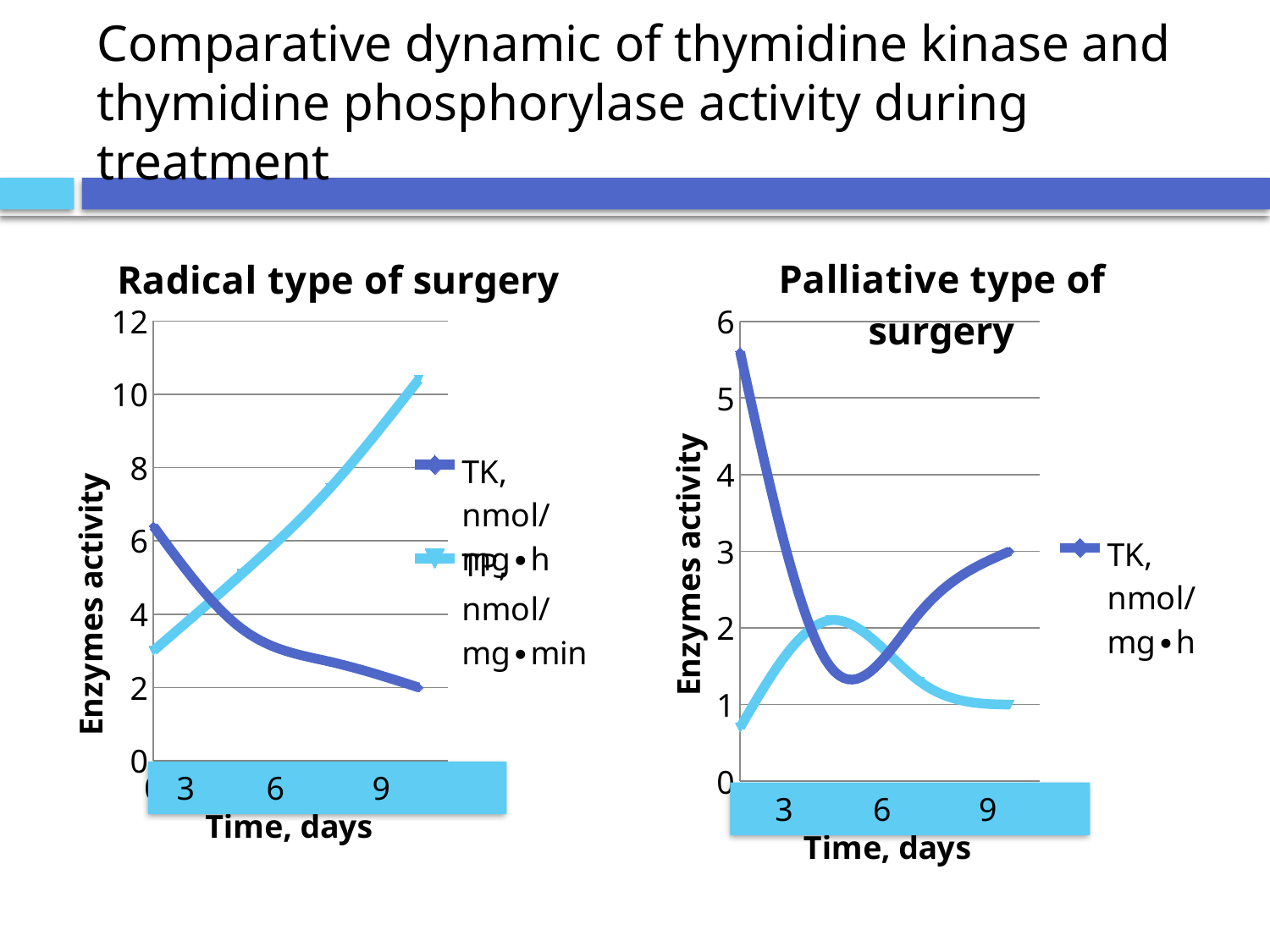
How many series does the legend of the 'Radical type of surgery' chart list? 2 What is the y-axis title of the 'Radical type of surgery' chart? Enzymes activity In the 'Radical type of surgery' chart, is the final value of the TP series greater or less than 8? greater How many series does the legend of the 'Palliative type of surgery' chart list? 1 In the 'Radical type of surgery' chart, what value does the TK series end at? 2 In the 'Palliative type of surgery' chart, what value does the TK series end at? 3 In the 'Radical type of surgery' chart, does the TK series rise or fall over time? fall What kind of chart is the 'Radical type of surgery' chart? line chart In the 'Radical type of surgery' chart, does the TP series rise or fall over time? rise In the 'Palliative type of surgery' chart, is the starting value of the TK series greater or less than 5? greater In the 'Palliative type of surgery' chart, at the start of the period, which series has the larger value: the dark blue TK line or the light blue line? TK In the 'Radical type of surgery' chart, which series reaches the highest value? TP